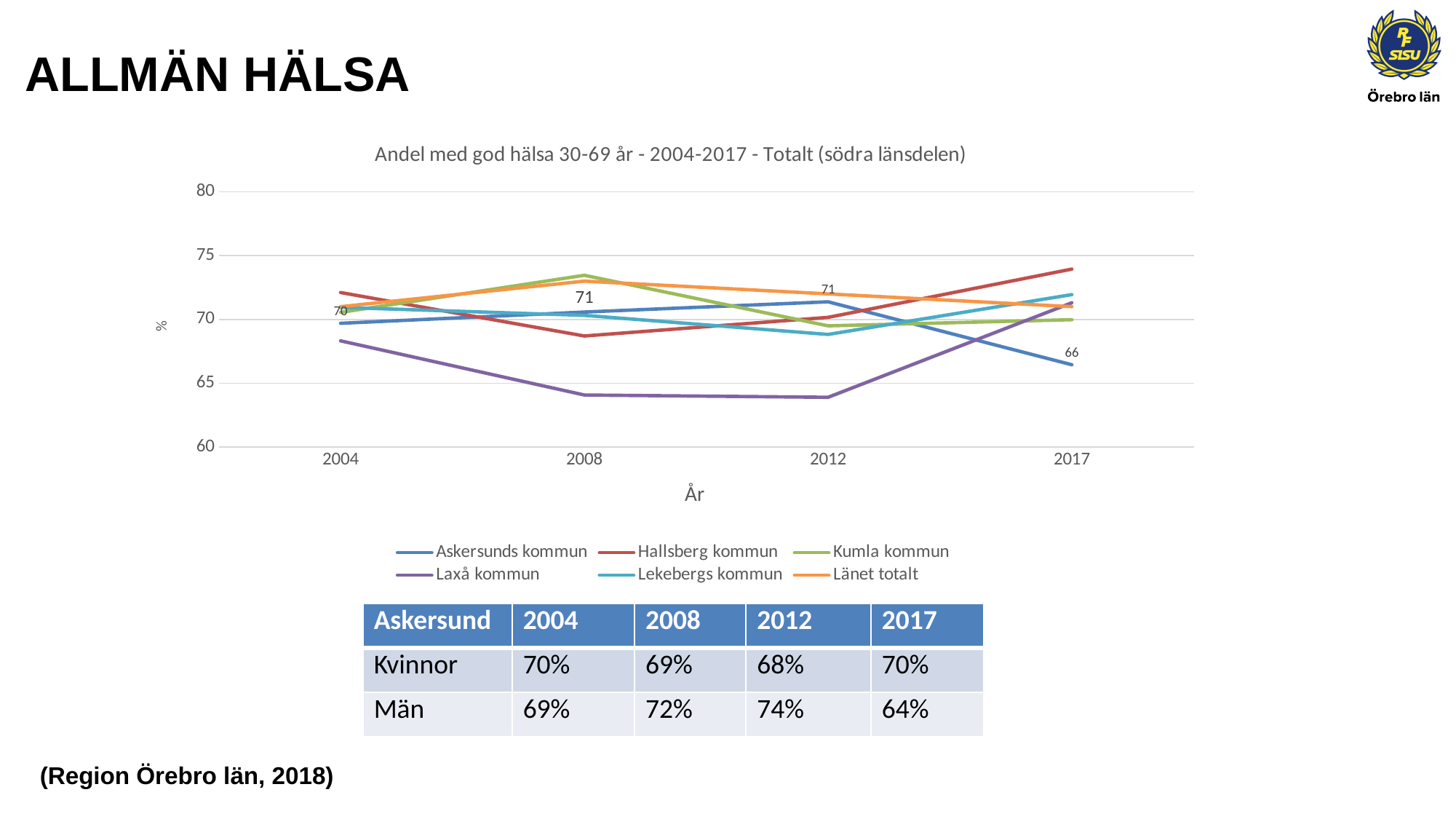
Is the value for Laxå kommun in 2008 greater or less than 65? less How many series does the chart legend list? 6 What is the value for Askersunds kommun in 2004? 70 Which is larger for Askersunds kommun: the value in 2008 or the value in 2017? 2008 What is the value for Askersunds kommun in 2017? 66 What is the value for Askersunds kommun in 2012? 71 Is the value for Hallsberg kommun in 2017 greater or less than 70? greater Which series has the highest value in 2017? Hallsberg kommun By how much did the value for Askersunds kommun fall between 2012 and 2017? 5 What kind of chart is shown on the slide? line chart Which series has the lowest value in 2012? Laxå kommun How many years are plotted along the x axis of the chart? 4